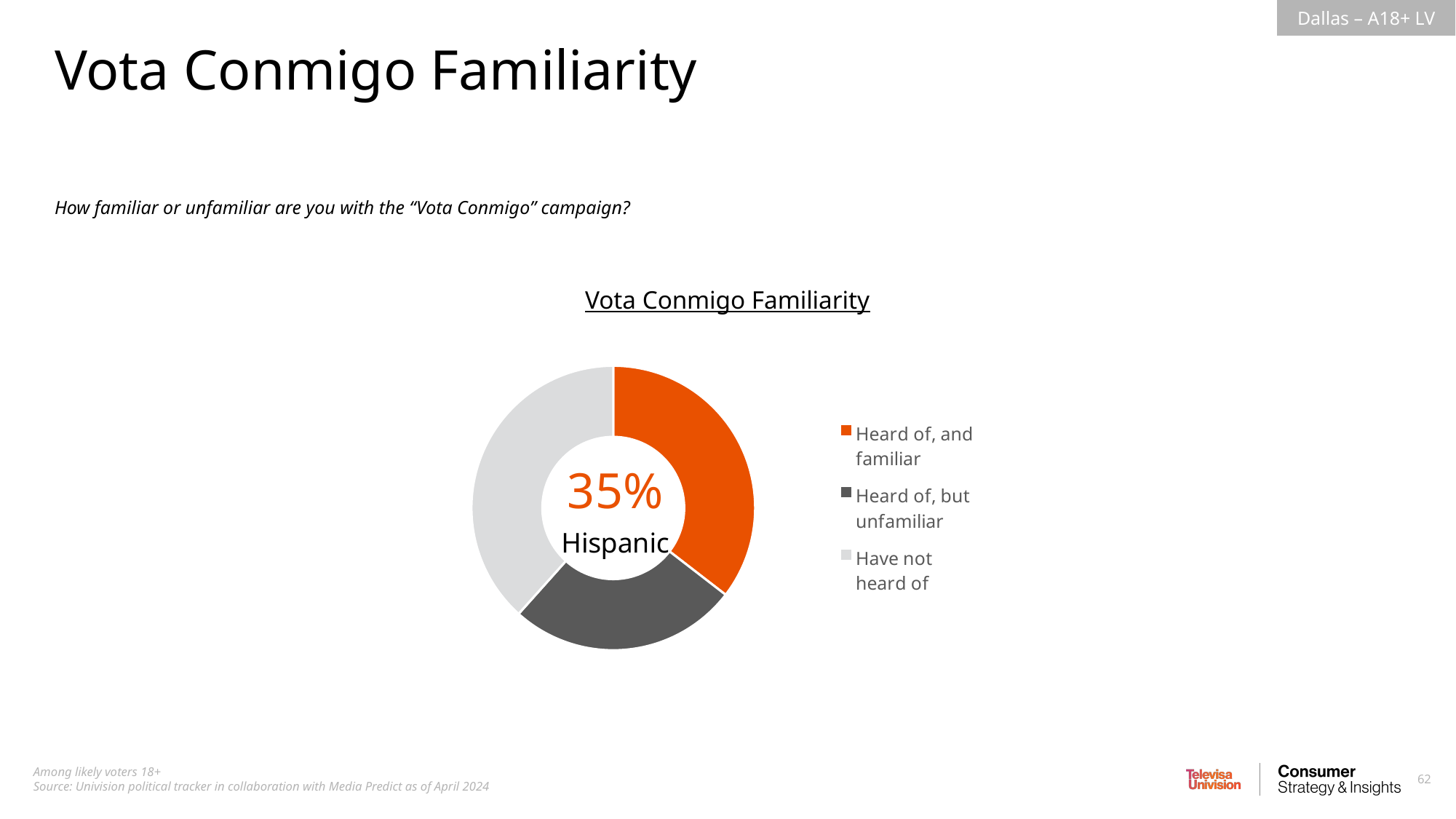
Is the share for 'Have not heard of' greater or less than 25%? greater Which legend category is shown in light gray? Have not heard of Is the share for 'Heard of, and familiar' greater or less than 50%? less How many categories does the chart's legend list? 3 Which group label appears in the center of the donut chart below the percentage? Hispanic How many segments does the donut chart have? 3 Which legend category is shown in orange? Heard of, and familiar What share of Hispanic likely voters have heard of, and are familiar with, the Vota Conmigo campaign? 35% What percentage is printed in the center of the donut chart? 35% What kind of chart is shown on the slide? Donut (pie) chart